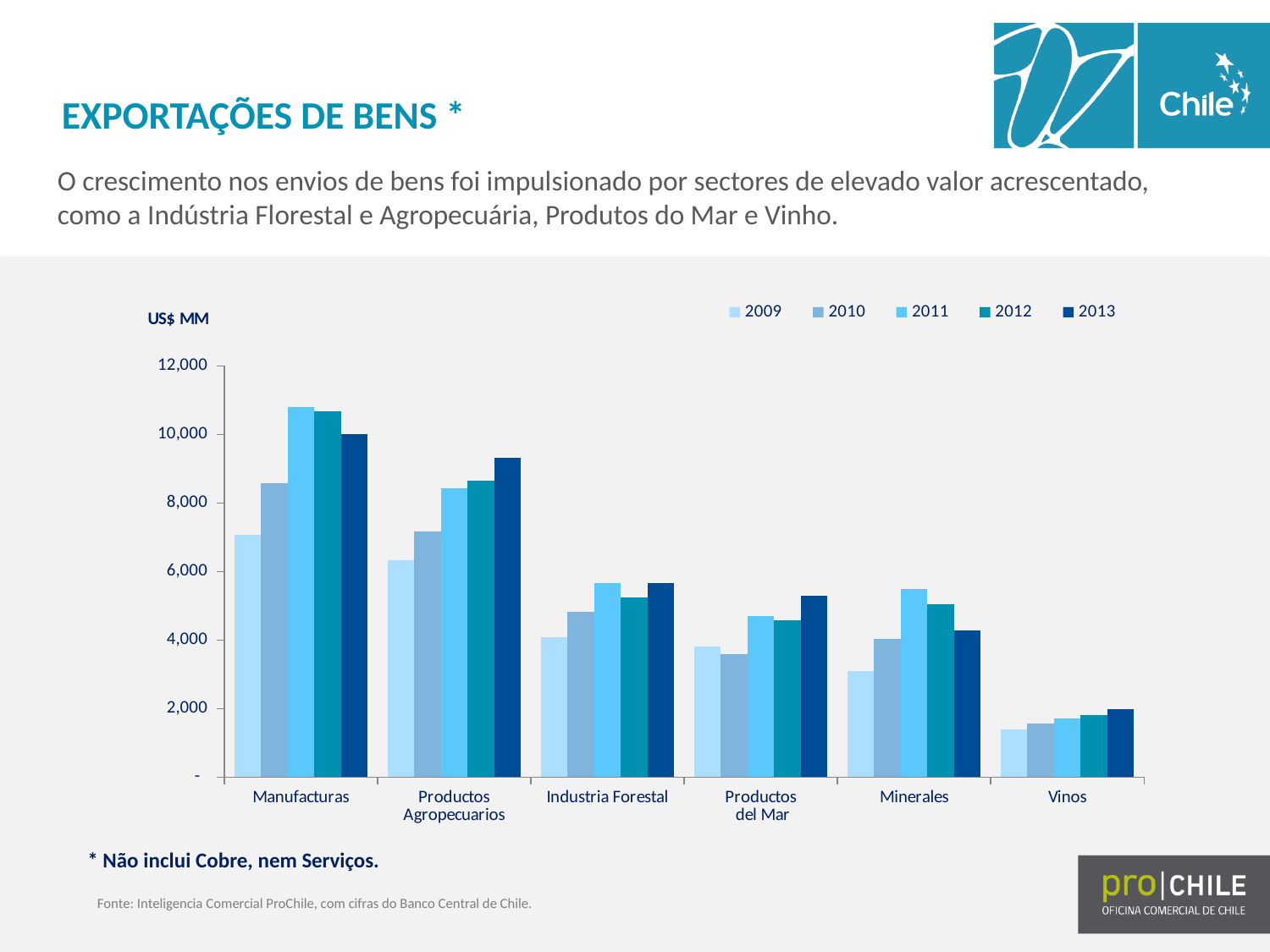
Is the value for Manufacturas in 2011 greater or less than 10,000? greater How many series does the legend list? 5 Which category has the lowest value for 2013? Vinos Do the values for Vinos rise or fall from 2009 to 2013? rise How many categories are shown on the x axis? 6 What kind of chart is shown on the slide? bar chart Which is larger in 2013: Productos Agropecuarios or Industria Forestal? Productos Agropecuarios Is the value for Minerales in 2009 greater or less than 4,000? less Which category has the highest value for 2013? Manufacturas Which is larger for Minerales: the 2011 value or the 2013 value? 2011 Is the value for Vinos in 2009 greater or less than 2,000? less What unit label is shown above the vertical axis? US$ MM